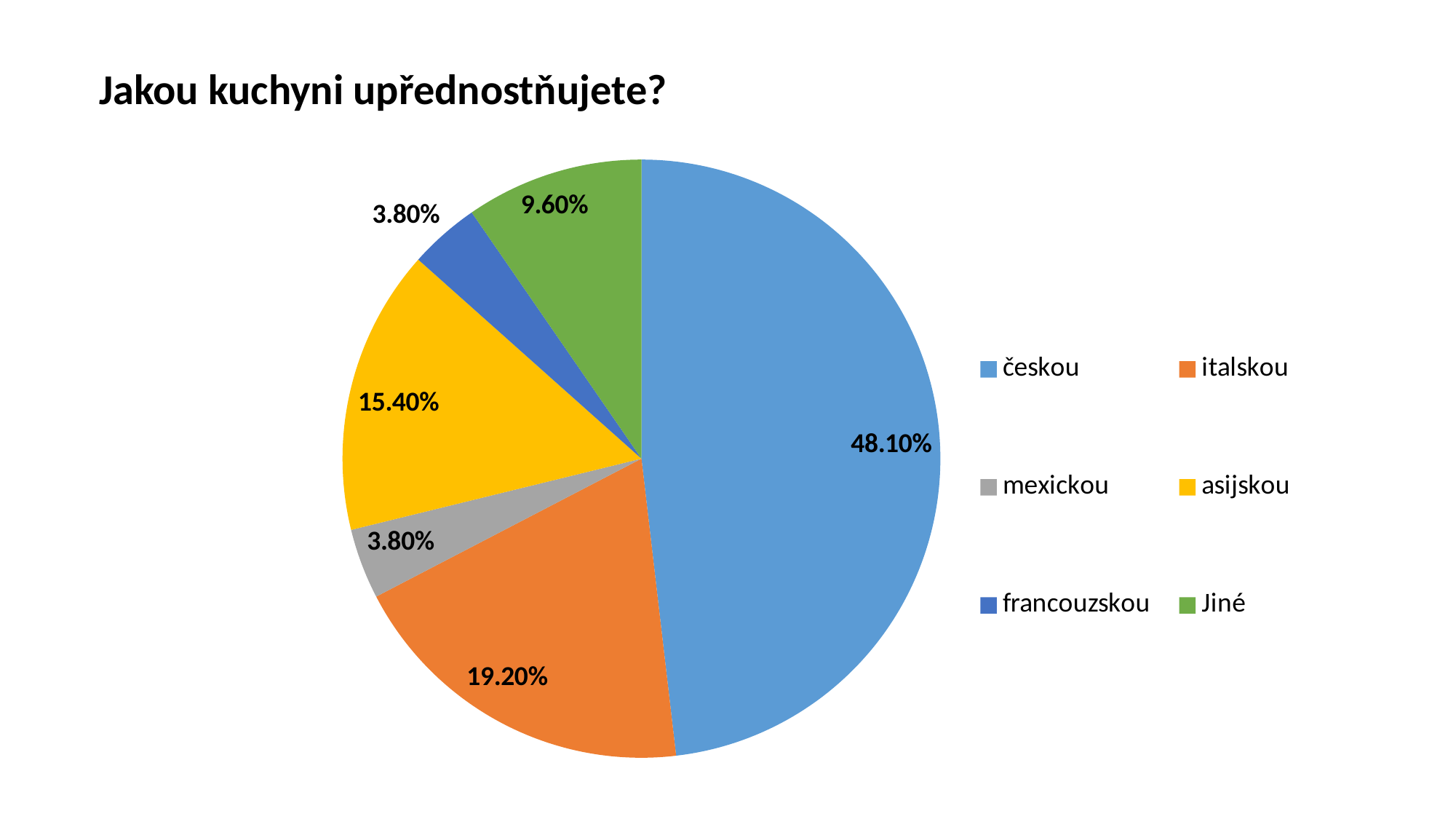
What colour is the slice for asijskou? yellow What percentage is shown for českou? 48.10% What percentage is shown for asijskou? 15.40% What percentage is shown for Jiné? 9.60% Which is larger, the slice for italskou or the slice for asijskou? italskou What percentage is shown for francouzskou? 3.80% What type of chart is shown on the slide? pie chart How many slices does the pie chart have? 6 What percentage is shown for italskou? 19.20% Which category has the largest slice of the pie? českou What is the difference between the percentages for českou and italskou? 28.90% What is the title of the chart? Jakou kuchyni upřednostňujete?